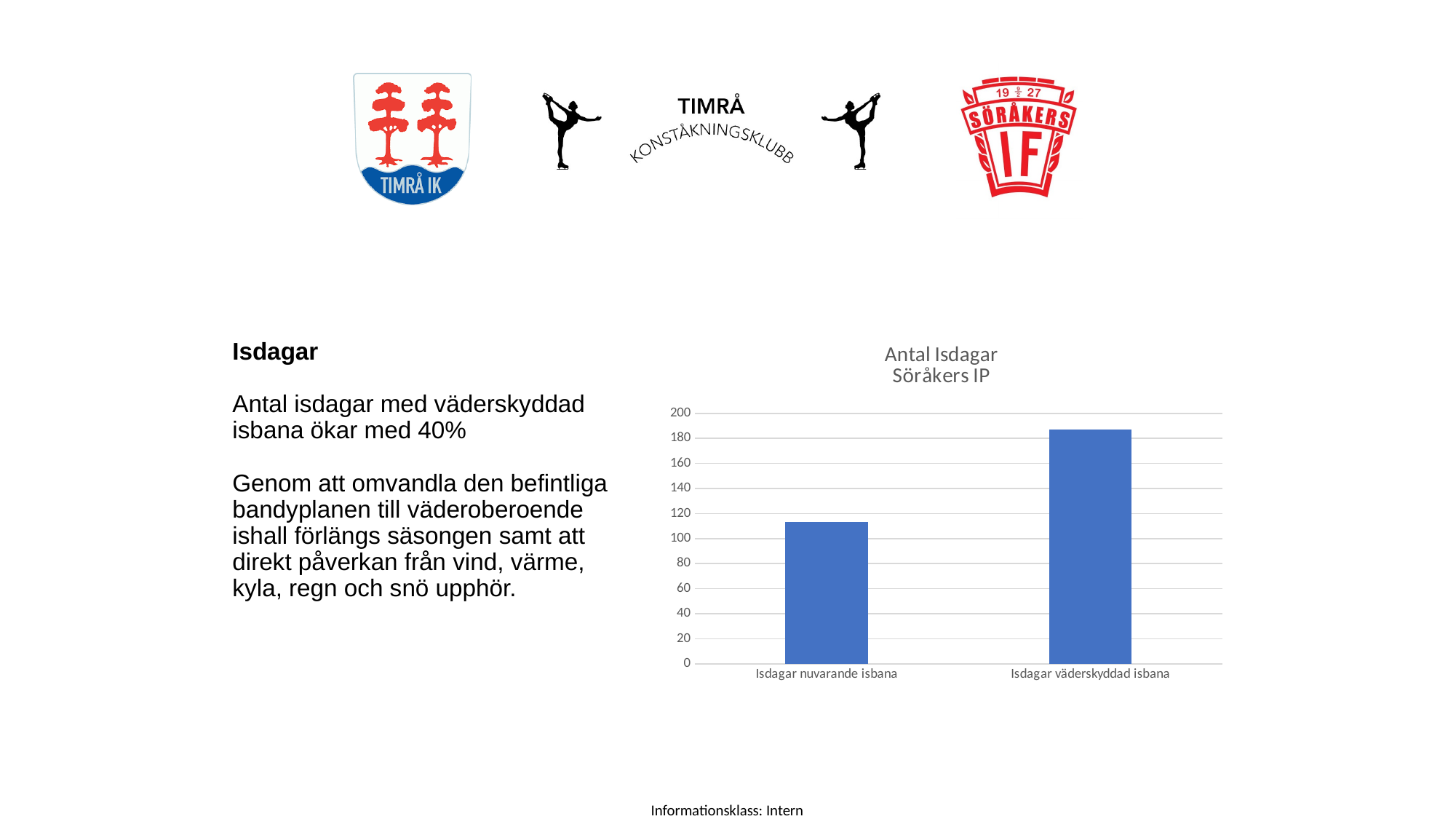
Which is larger, the value for Isdagar nuvarande isbana or the value for Isdagar väderskyddad isbana? Isdagar väderskyddad isbana How many bars does the chart show? 2 Is the value for Isdagar väderskyddad isbana greater or less than 200? less Is the value for Isdagar nuvarande isbana greater or less than 100? greater What type of chart is shown on the slide? bar chart Which category has the highest value? Isdagar väderskyddad isbana What is the title of the chart? Antal Isdagar Söråkers IP Is the value for Isdagar väderskyddad isbana greater or less than 180? greater Which category has the lowest value? Isdagar nuvarande isbana Do the values rise or fall from the left bar to the right bar? rise What is the highest value shown on the vertical axis? 200